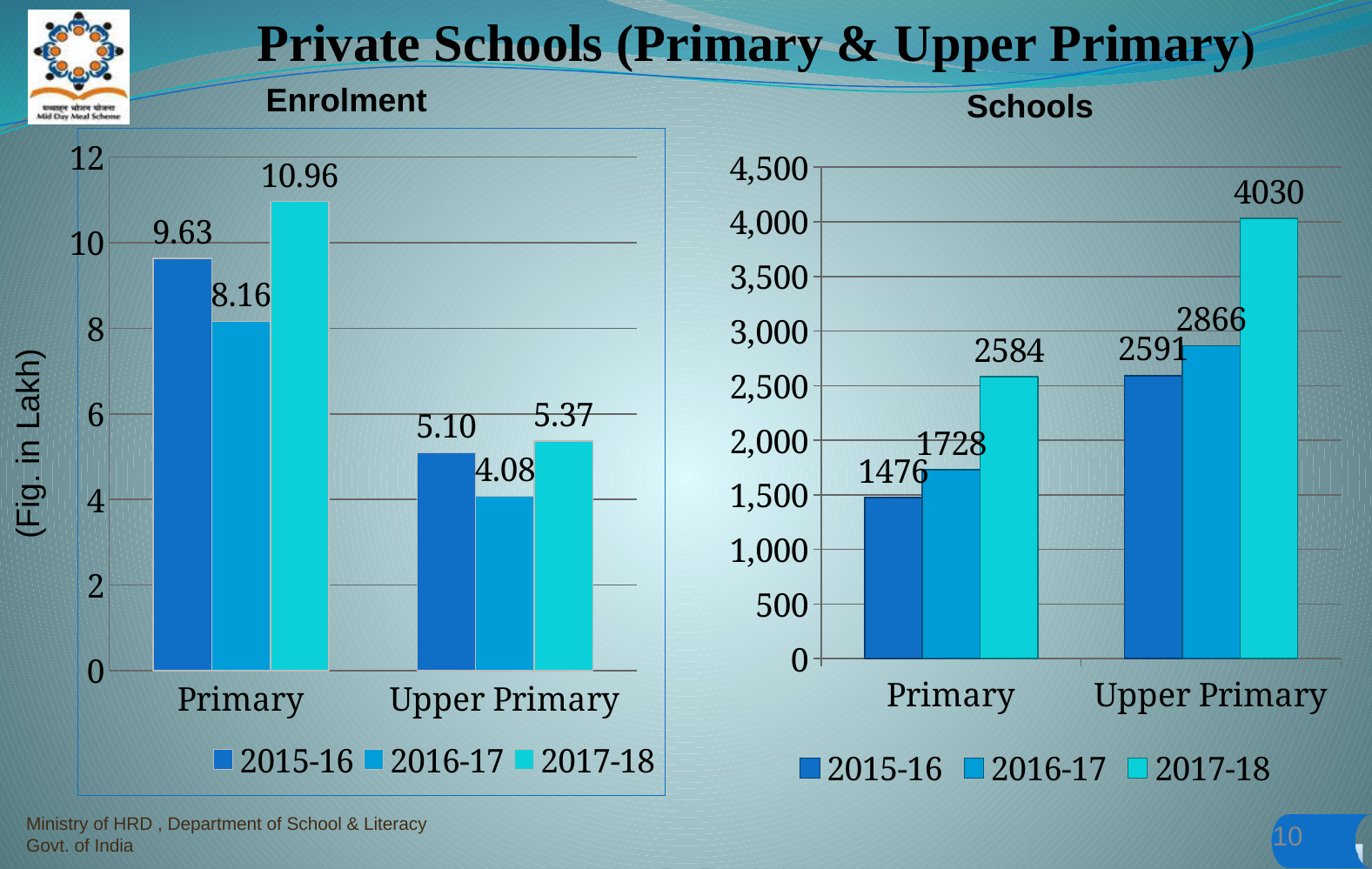
In the Schools chart, what is the difference between the Upper Primary and Primary values for 2017-18? 1446 In the Schools chart, what is the value for Primary in 2015-16? 1476 In the Schools chart, which year has the highest value for Upper Primary? 2017-18 In the Enrolment chart, what is the value for Primary in 2017-18? 10.96 What kind of chart is the Enrolment chart? Bar chart In the Enrolment chart, which year has the lowest value for Primary? 2016-17 In the Enrolment chart, what is the difference between the Primary values for 2017-18 and 2015-16? 1.33 How many series does the legend of the Schools chart list? 3 In the Schools chart, which is larger: Primary in 2016-17 or Upper Primary in 2015-16? Upper Primary in 2015-16 What unit is shown on the y-axis label of the Enrolment chart? Fig. in Lakh In the Enrolment chart, what is the value for Upper Primary in 2016-17? 4.08 In the Schools chart, what is the value for Upper Primary in 2017-18? 4030